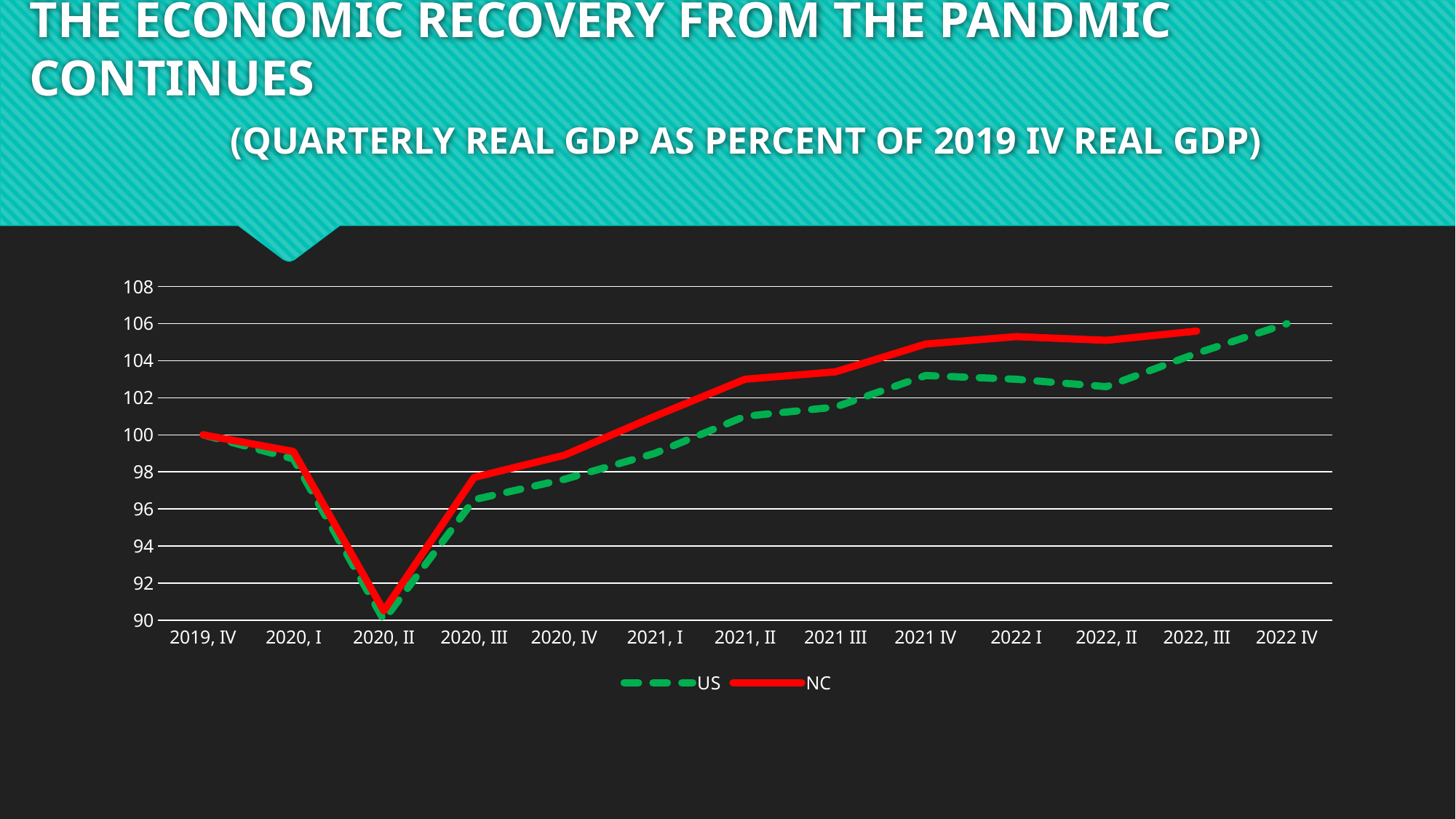
Is the value for NC at 2020, II greater or less than 92? less Is the value for NC at 2021, II greater or less than 102? greater Between 2020, II and 2021 IV, does the NC series rise or fall? rise What kind of chart is shown on the slide? line chart In which quarter does the US series reach its highest value? 2022 IV How many series does the legend list? 2 Is the value for US at 2020, III greater or less than 98? less In which quarter does the NC series reach its lowest value? 2020, II At 2021 IV, which series has the higher value, US or NC? NC What colour is the NC line? red How many quarters are labelled along the x axis? 13 What is the value for NC at 2019, IV? 100